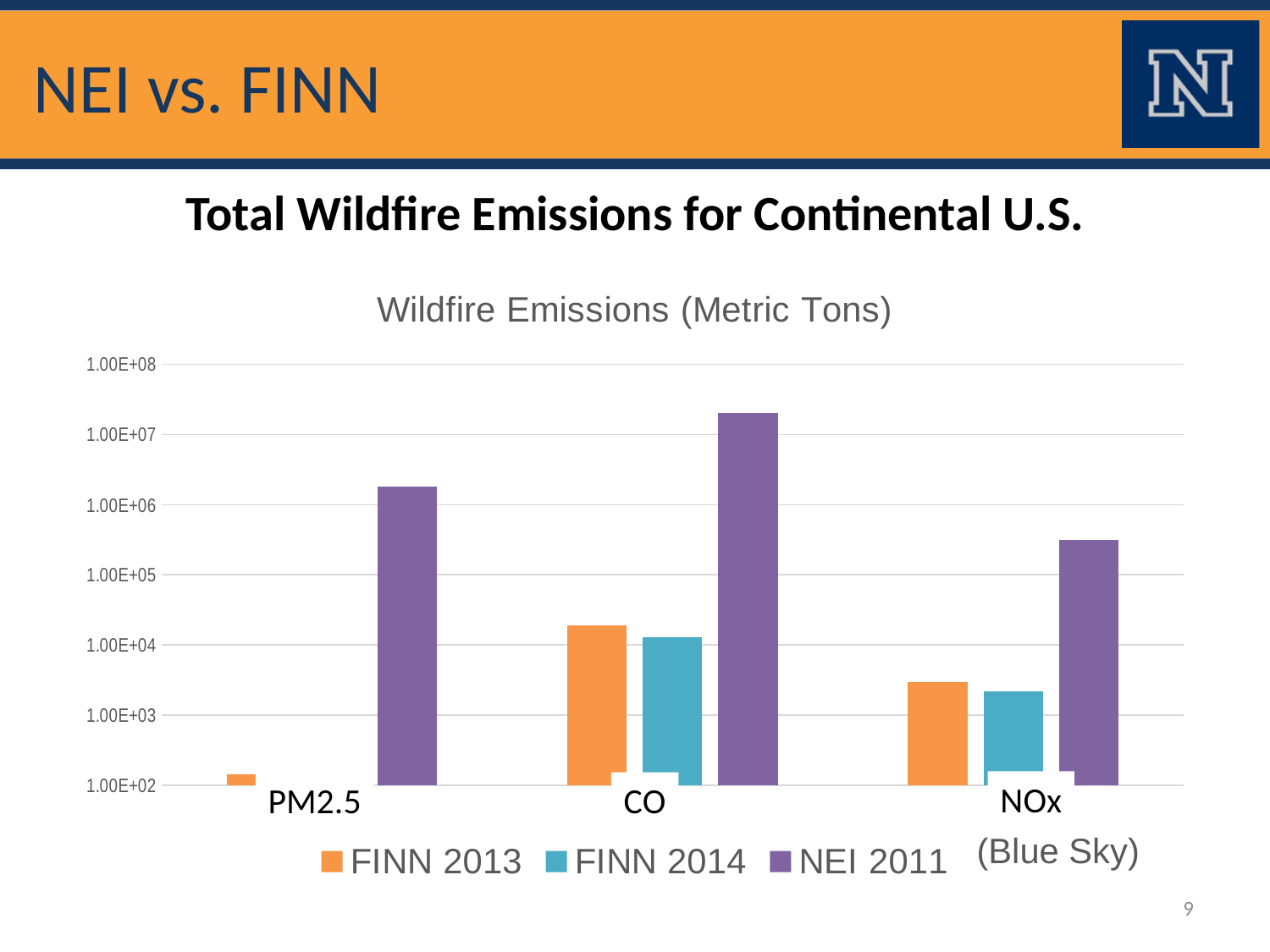
For NOx, which is larger: the FINN 2013 value or the NEI 2011 value? NEI 2011 Is the NEI 2011 value for CO greater or less than 1.00E+07? greater Which series is shown in purple in the legend? NEI 2011 How many pollutant categories are shown on the x axis? 3 Is the NEI 2011 value for PM2.5 greater or less than 1.00E+06? greater Is the NEI 2011 value for NOx greater or less than 1.00E+06? less What kind of chart is shown on the slide? bar chart Which category has the lowest FINN 2013 value? PM2.5 What is the title of the chart? Wildfire Emissions (Metric Tons) Which category has the highest NEI 2011 value? CO How many series does the legend list? 3